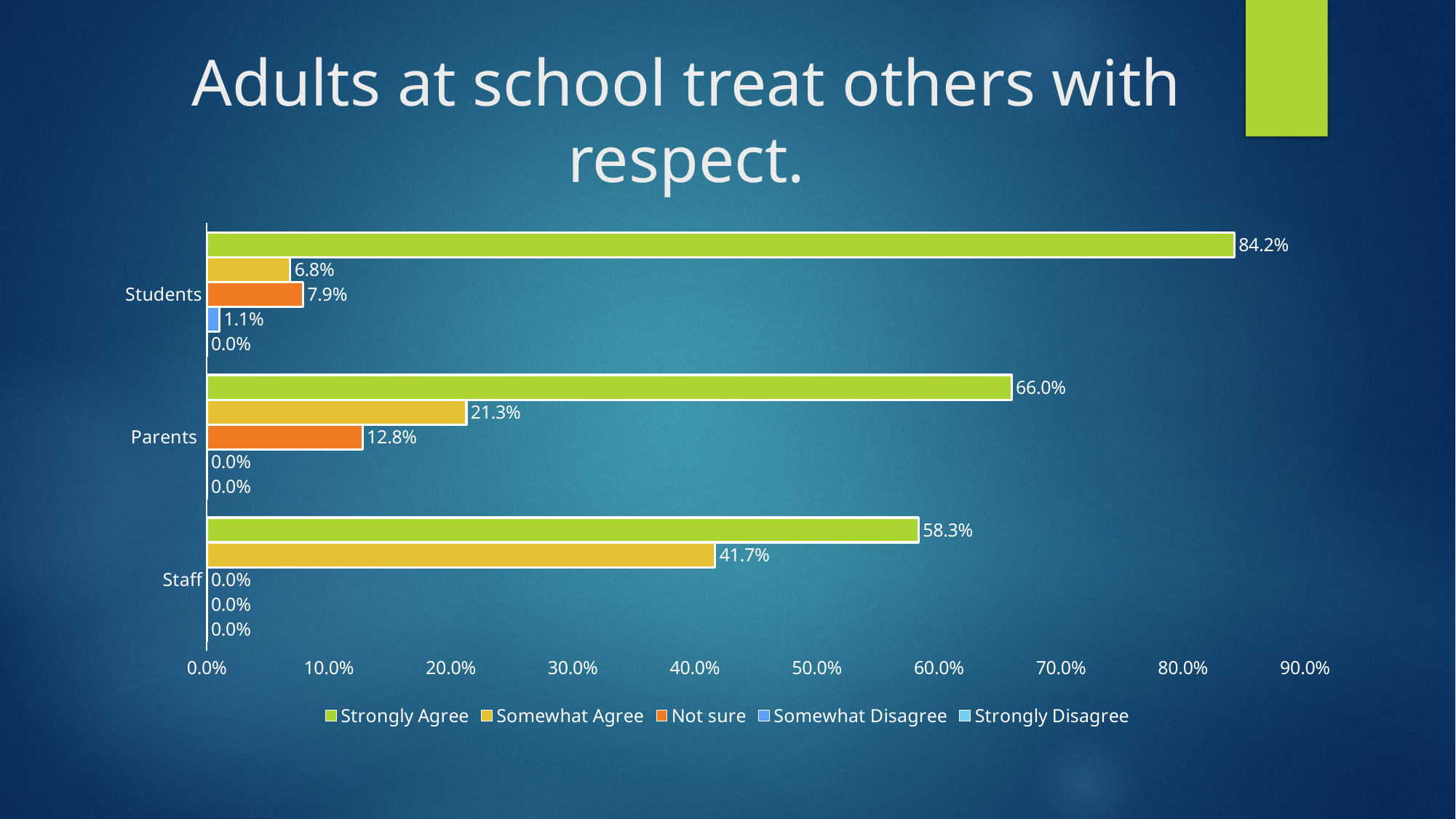
What type of chart is shown on the slide? Bar chart What percentage of Students Strongly Agree that adults at school treat others with respect? 84.2% What is the Not sure value for Students? 7.9% What is the difference between the Strongly Agree values for Students and Parents? 18.2% What is the Somewhat Agree value for Parents? 21.3% Is the Strongly Agree value for Staff greater or less than 50.0%? greater What is the Somewhat Agree value for Staff? 41.7% How many series does the legend list? 5 Which group has the lowest Strongly Agree percentage? Staff Which group has the highest Strongly Agree percentage? Students How many groups are shown on the vertical axis? 3 Which is larger: the Not sure value for Parents or the Not sure value for Students? Parents